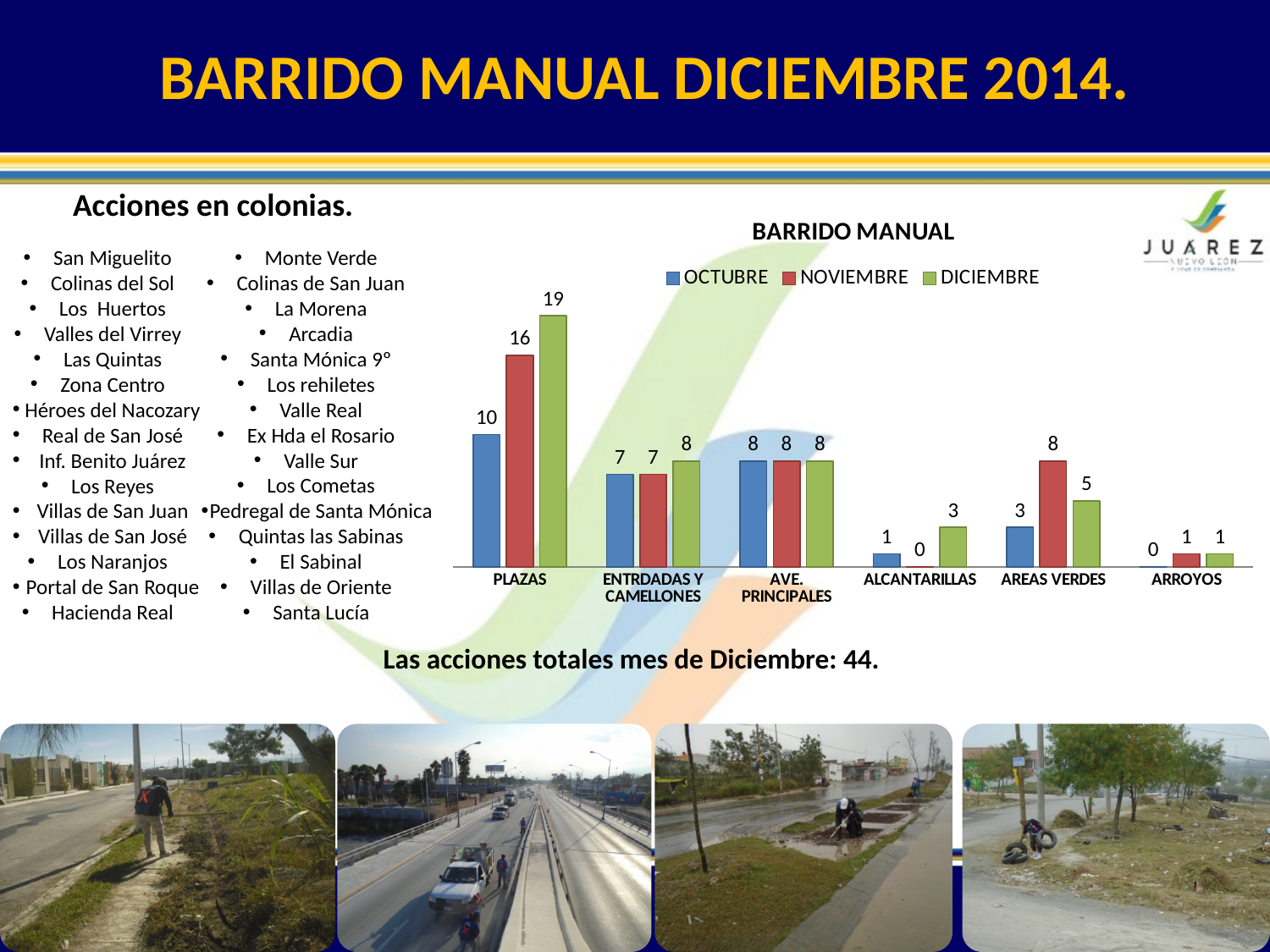
What is the DICIEMBRE value for PLAZAS? 19 How many series does the legend list? 3 How many categories are shown on the x axis? 6 Which category has the lowest OCTUBRE value? ARROYOS Which category has the highest DICIEMBRE value? PLAZAS Which is larger for AREAS VERDES, the NOVIEMBRE value or the DICIEMBRE value? NOVIEMBRE What is the title of the chart? BARRIDO MANUAL What kind of chart is shown? bar chart What is the difference between the DICIEMBRE and OCTUBRE values for PLAZAS? 9 What is the OCTUBRE value for ALCANTARILLAS? 1 What is the total of the DICIEMBRE values across all categories? 44 What is the NOVIEMBRE value for AREAS VERDES? 8